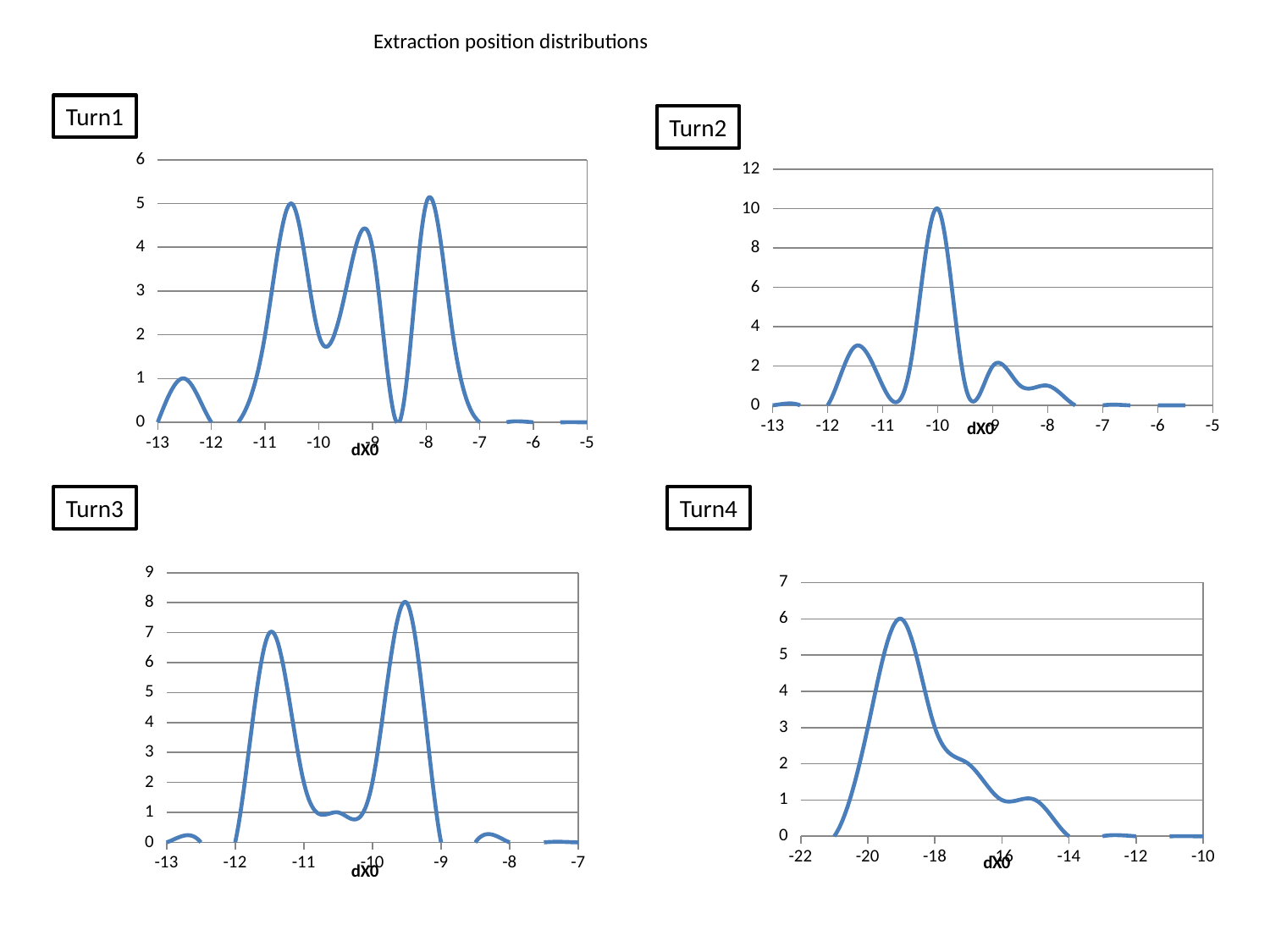
What is the title of the slide above the charts? Extraction position distributions How many charts are shown on the slide? 4 In the Turn2 chart, is the value at dX0 = -11.5 greater or less than 4? less What kind of chart is the Turn1 chart? line chart In the Turn3 chart, what is the value at the highest peak (near dX0 = -9.5)? 8 In the Turn4 chart, do the values rise or fall as dX0 goes from -19 to -14? fall In the Turn4 chart, is the value at dX0 = -17 greater or less than 3? less In the Turn1 chart, is the value at dX0 = -12.5 greater or less than 2? less In the Turn4 chart, what is the value at the highest peak (at dX0 = -19)? 6 In the Turn3 chart, which peak is higher: the one near dX0 = -11.5 or the one near dX0 = -9.5? the one near -9.5 In the Turn2 chart, what is the value at the highest peak (at dX0 = -10)? 10 What is the x-axis label on the Turn3 chart? dX0